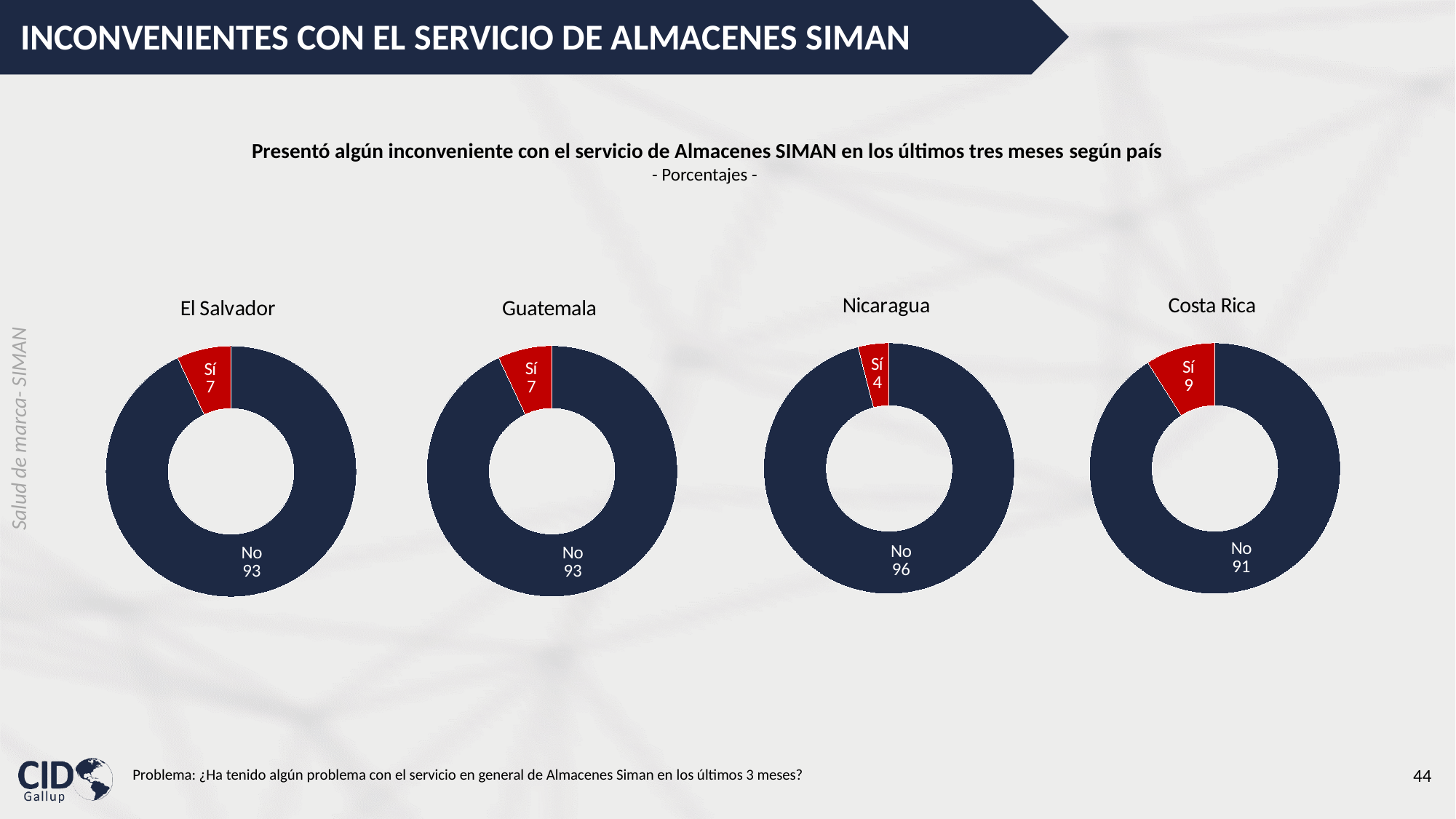
In the Guatemala chart, what is the value for "No"? 93 What colour is the "Sí" slice in each chart? Red Across the four charts, which country has the lowest "Sí" value? Nicaragua Across the four charts, which country has the highest "Sí" value? Costa Rica How many donut charts are shown on the slide? 4 What kind of chart is used for each country on the slide? Donut (pie) chart In the El Salvador chart, what share of the donut does the "No" slice represent? 93 In the Nicaragua chart, what is the value for "No"? 96 In the El Salvador chart, what is the value for "Sí"? 7 What is the difference between the "No" value in the Nicaragua chart and the "No" value in the Costa Rica chart? 5 Is the "Sí" value larger in the Costa Rica chart or in the Nicaragua chart? Costa Rica In the Costa Rica chart, what is the value for "Sí"? 9